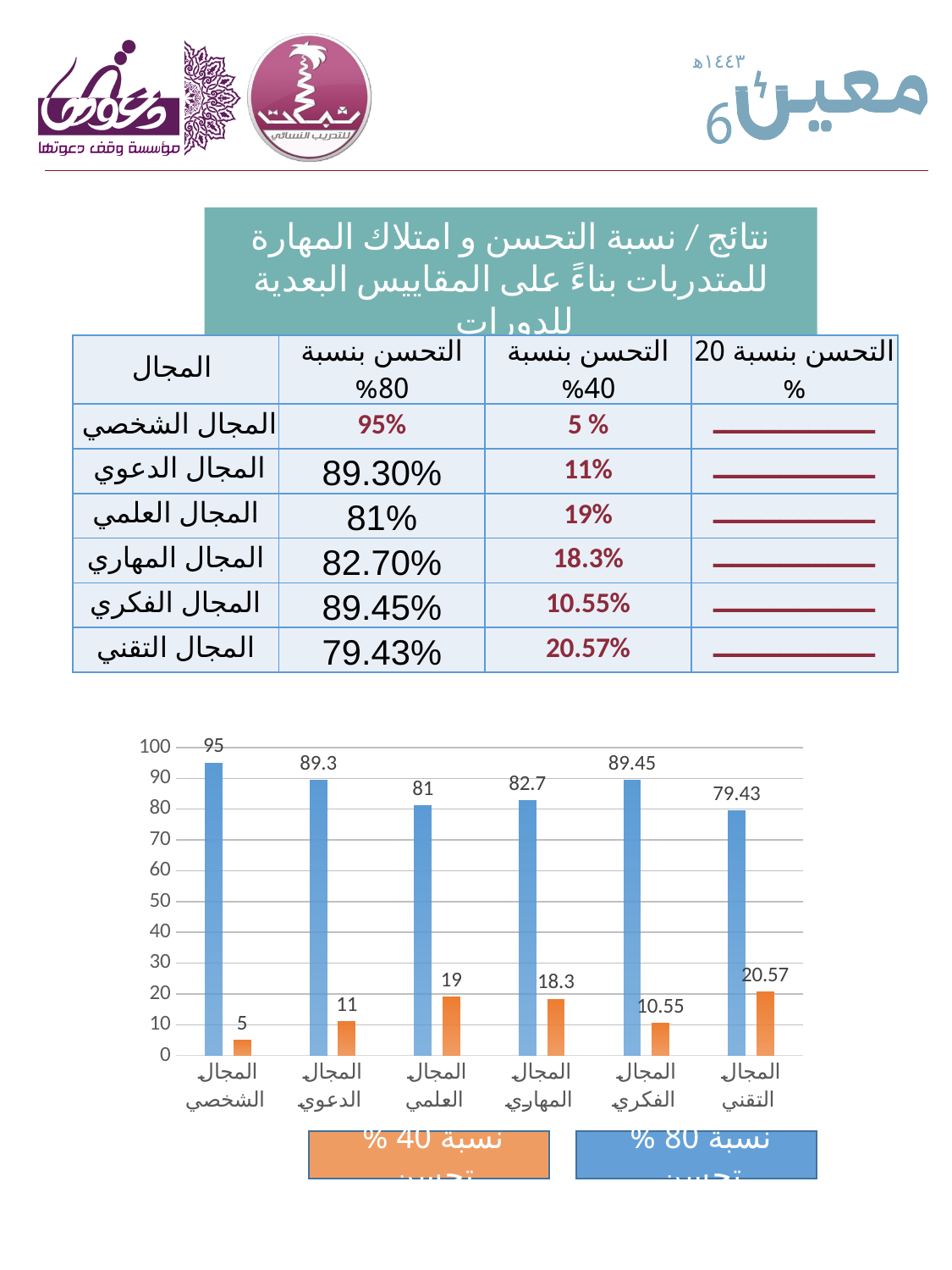
What is the difference between the blue bar values for المجال الشخصي and المجال التقني? 15.57 What is the value of the orange bar for المجال المهاري? 18.3 What is the value of the blue bar for المجال الفكري? 89.45 Which category has the highest blue bar? المجال الشخصي What is the value of the blue bar for المجال الشخصي? 95 Which category has the lowest orange bar? المجال الشخصي How many series does the chart show? 2 What type of chart is shown on the slide? Bar chart What is the value of the orange bar for المجال التقني? 20.57 How many categories are shown on the x axis of the chart? 6 Which category has the lowest blue bar? المجال التقني Which is larger: the orange bar for المجال العلمي or the orange bar for المجال الدعوي? المجال العلمي